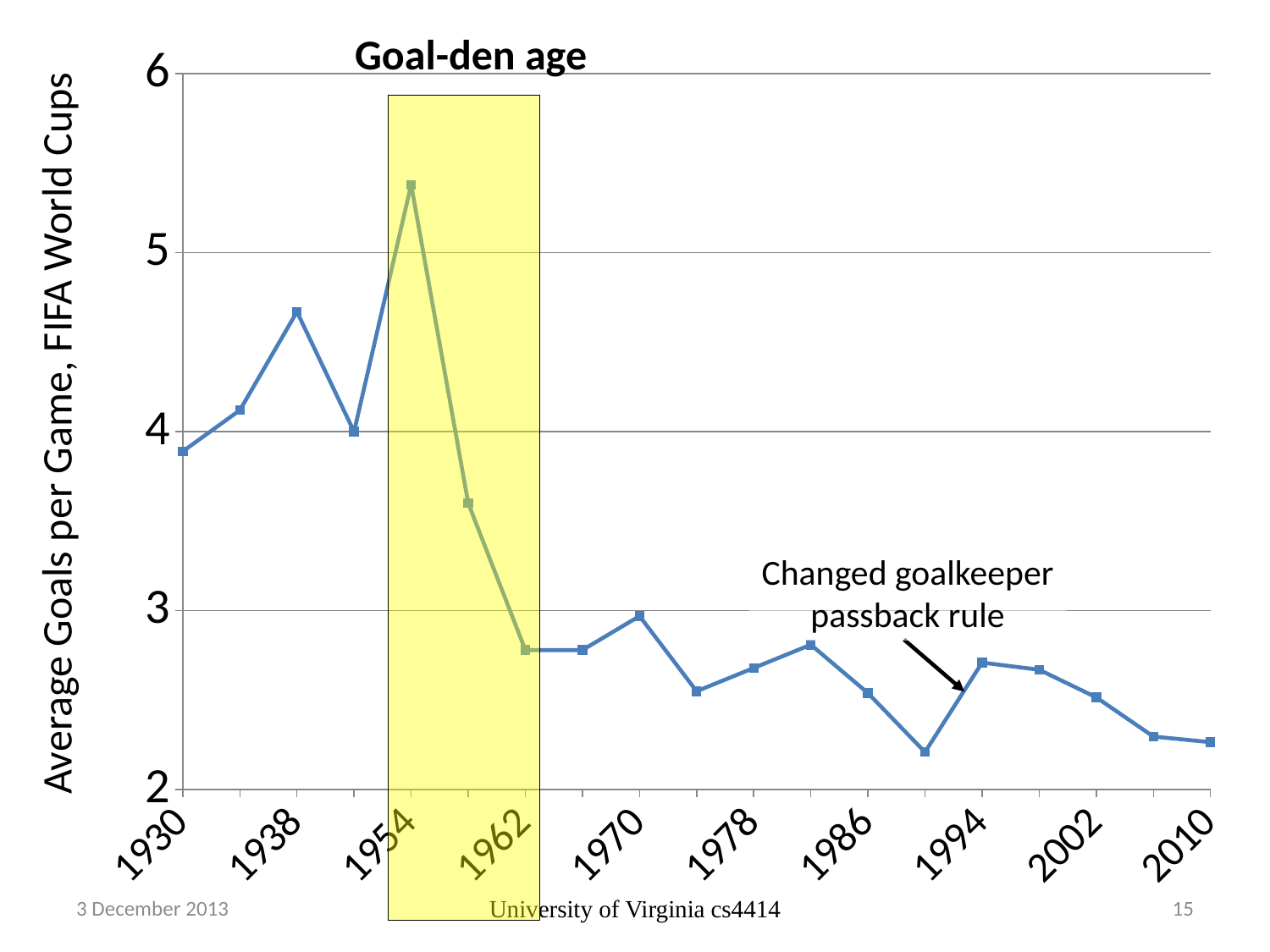
Is the value for 1930 greater or less than 4? less Is the value for 1938 greater or less than 4? greater Which year has the highest average goals per game? 1954 Is the value for 1954 greater or less than 5? greater What is the label on the vertical axis? Average Goals per Game, FIFA World Cups What is the title of the chart? Goal-den age What kind of chart is shown on the slide? line chart Which is larger, the value for 1938 or the value for 1962? 1938 Do the values rise or fall from 1954 to 1962? fall Which is larger, the value for 1954 or the value for 1994? 1954